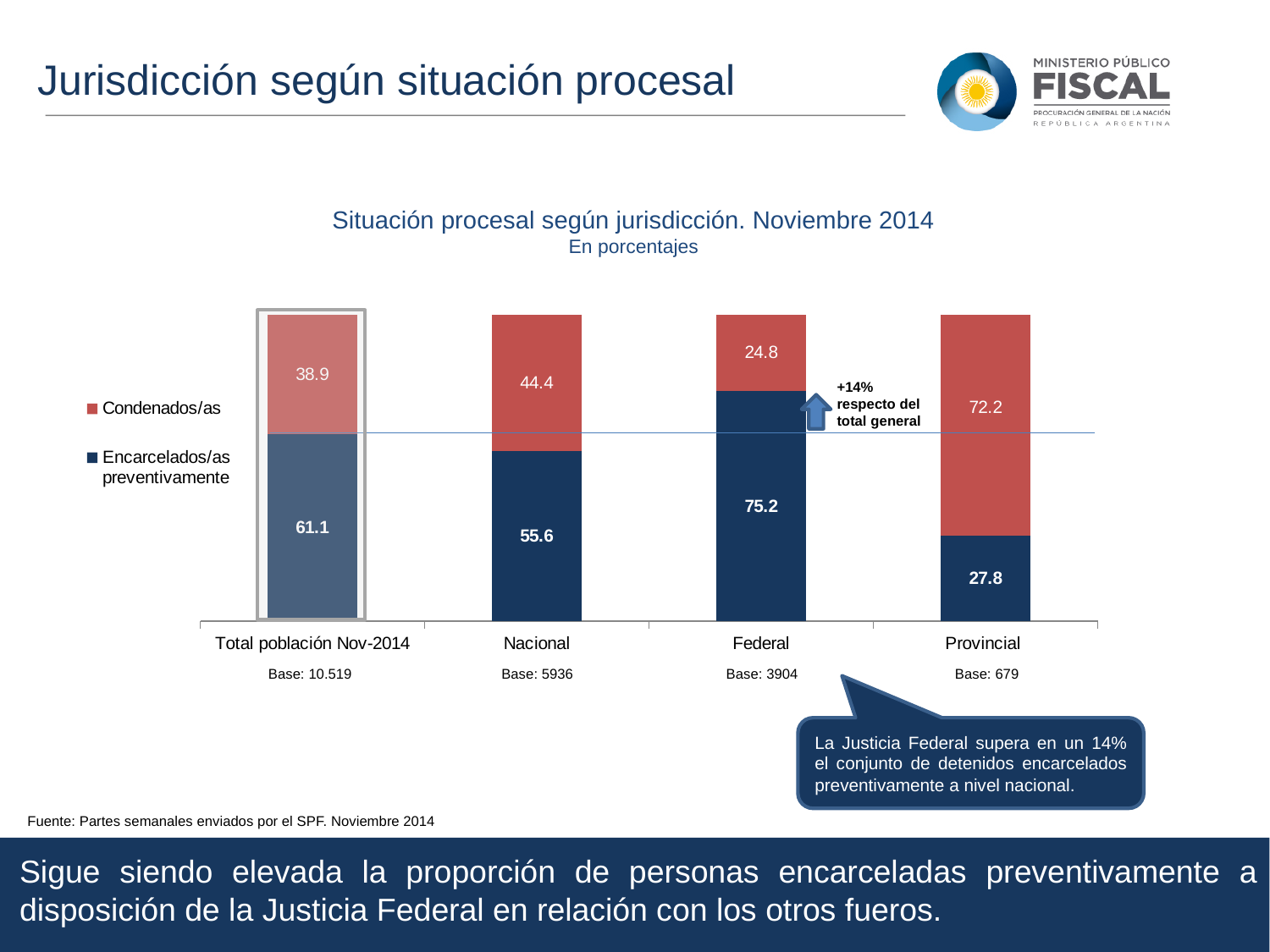
Which category has the highest value for Encarcelados/as preventivamente? Federal What is the value for Condenados/as in the Provincial category? 72.2 What kind of chart is shown on the slide? Stacked bar chart Which category has the lowest value for Condenados/as? Federal What is the value for Condenados/as in the Nacional category? 44.4 What is the difference between the Encarcelados/as preventivamente values for Federal and Nacional? 19.6 How many categories are shown on the x axis? 4 What is the base (number of cases) shown under the Federal category? Base: 3904 Which is larger: the Condenados/as value for Provincial or for Nacional? Provincial What is the value for Encarcelados/as preventivamente in the Total población Nov-2014 category? 61.1 How many series does the legend list? 2 What is the value for Encarcelados/as preventivamente in the Federal category? 75.2